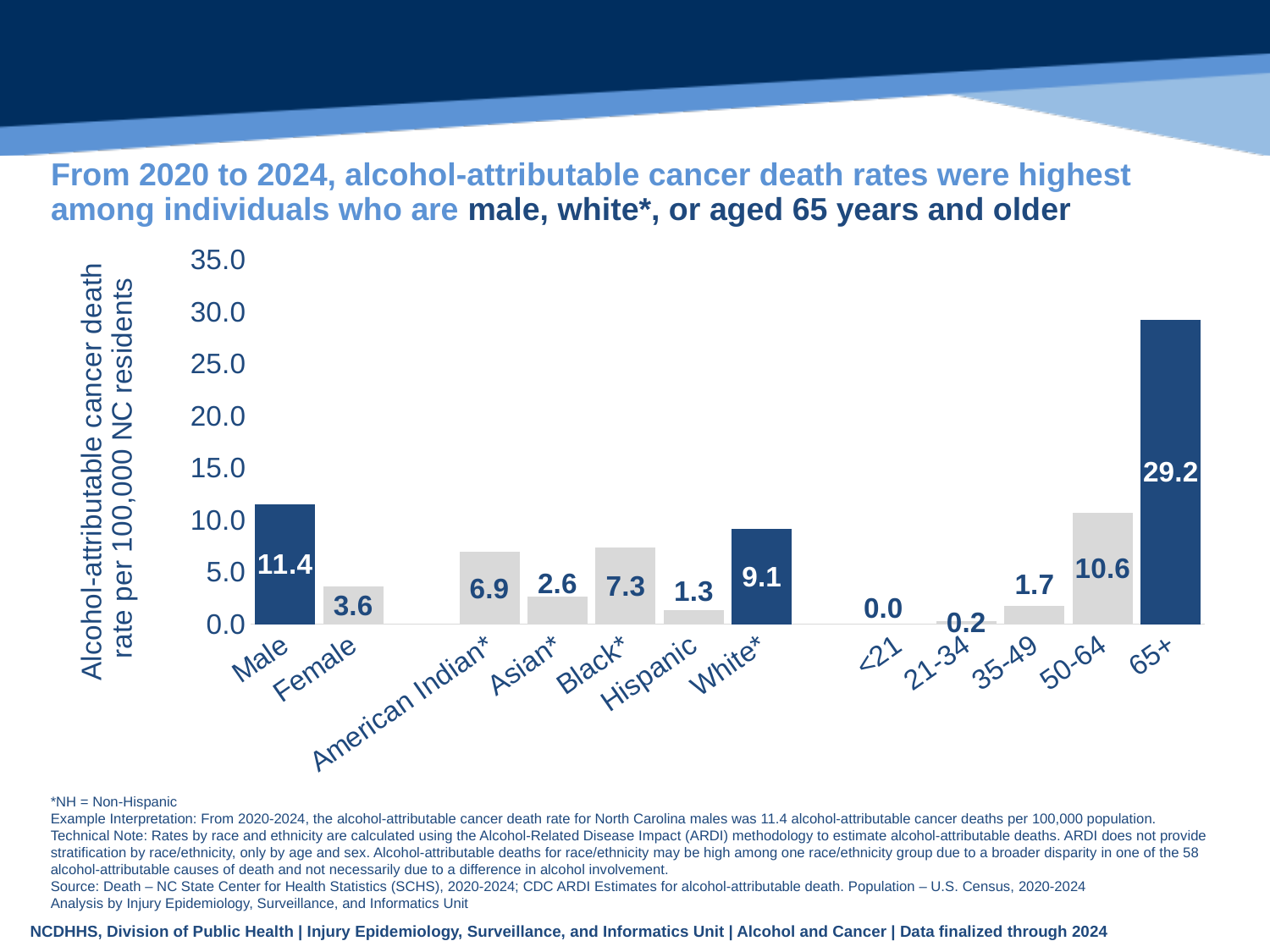
Which has a higher alcohol-attributable cancer death rate, White* or Black*? White* Which has a higher alcohol-attributable cancer death rate, American Indian* or Asian*? American Indian* What is the difference between the death rates for the 65+ and 50-64 age groups? 18.6 What is the difference between the male and female alcohol-attributable cancer death rates? 7.8 Which category has the lowest alcohol-attributable cancer death rate? <21 What type of chart is shown on the slide? Bar chart What is the alcohol-attributable cancer death rate for Hispanic residents? 1.3 Which category has the highest alcohol-attributable cancer death rate? 65+ How many categories are shown on the x axis of the chart? 12 What is the alcohol-attributable cancer death rate for the 65+ age group? 29.2 What is the alcohol-attributable cancer death rate for males? 11.4 Do the death rates rise or fall across the age groups from <21 to 65+? Rise